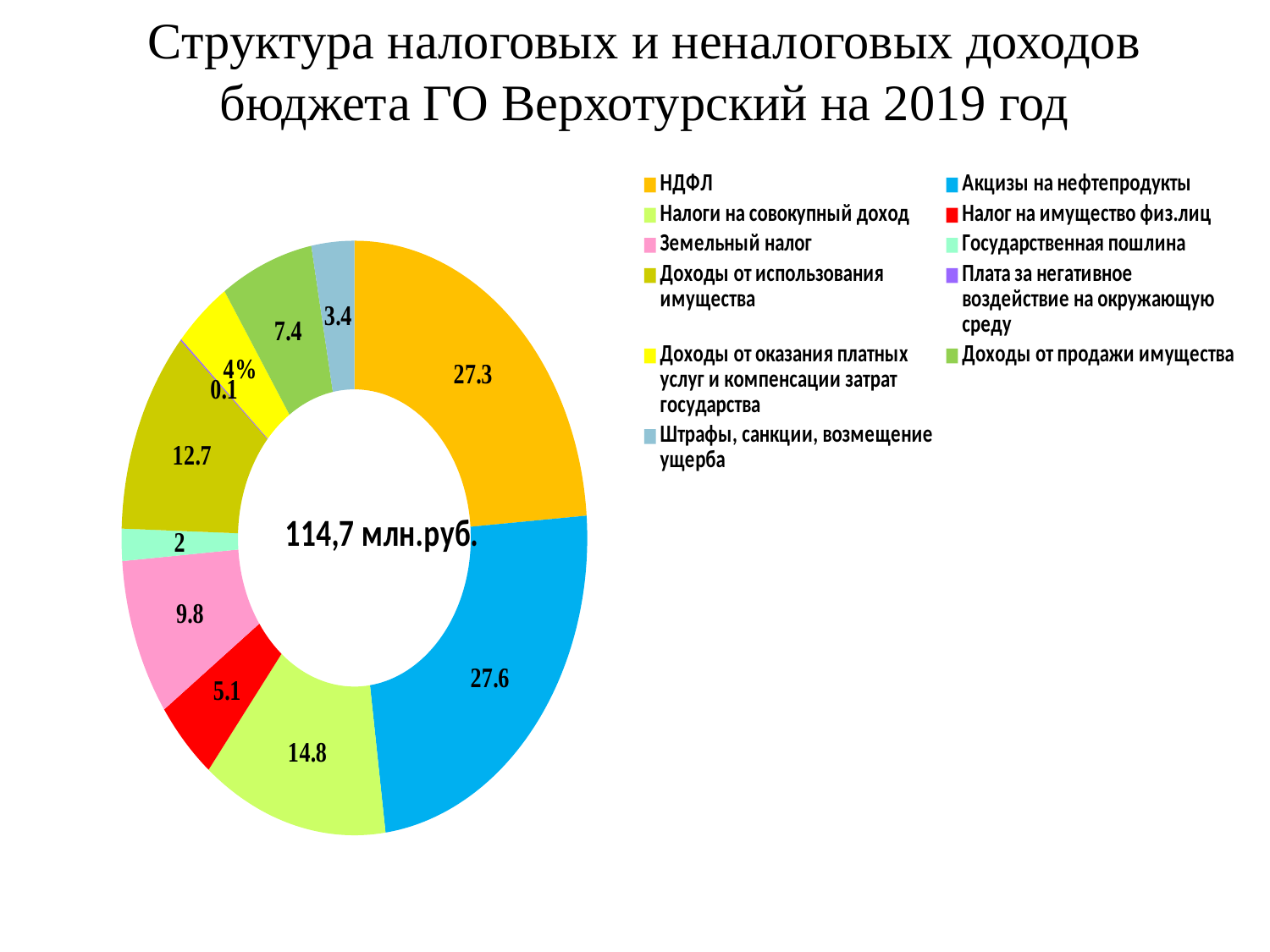
What is the difference between the values for Акцизы на нефтепродукты and НДФЛ? 0.3 What value is shown for НДФЛ? 27.3 Which category has the smallest slice? Плата за негативное воздействие на окружающую среду Which is larger, Налоги на совокупный доход or Земельный налог? Налоги на совокупный доход Which category has the largest slice? Акцизы на нефтепродукты What value is shown for Акцизы на нефтепродукты? 27.6 What value is shown for Земельный налог? 9.8 What value is shown for Доходы от использования имущества? 12.7 How many categories does the chart show? 11 What value is shown for Штрафы, санкции, возмещение ущерба? 3.4 What total is printed in the centre of the chart? 114,7 млн.руб. What kind of chart is shown on the slide? doughnut chart